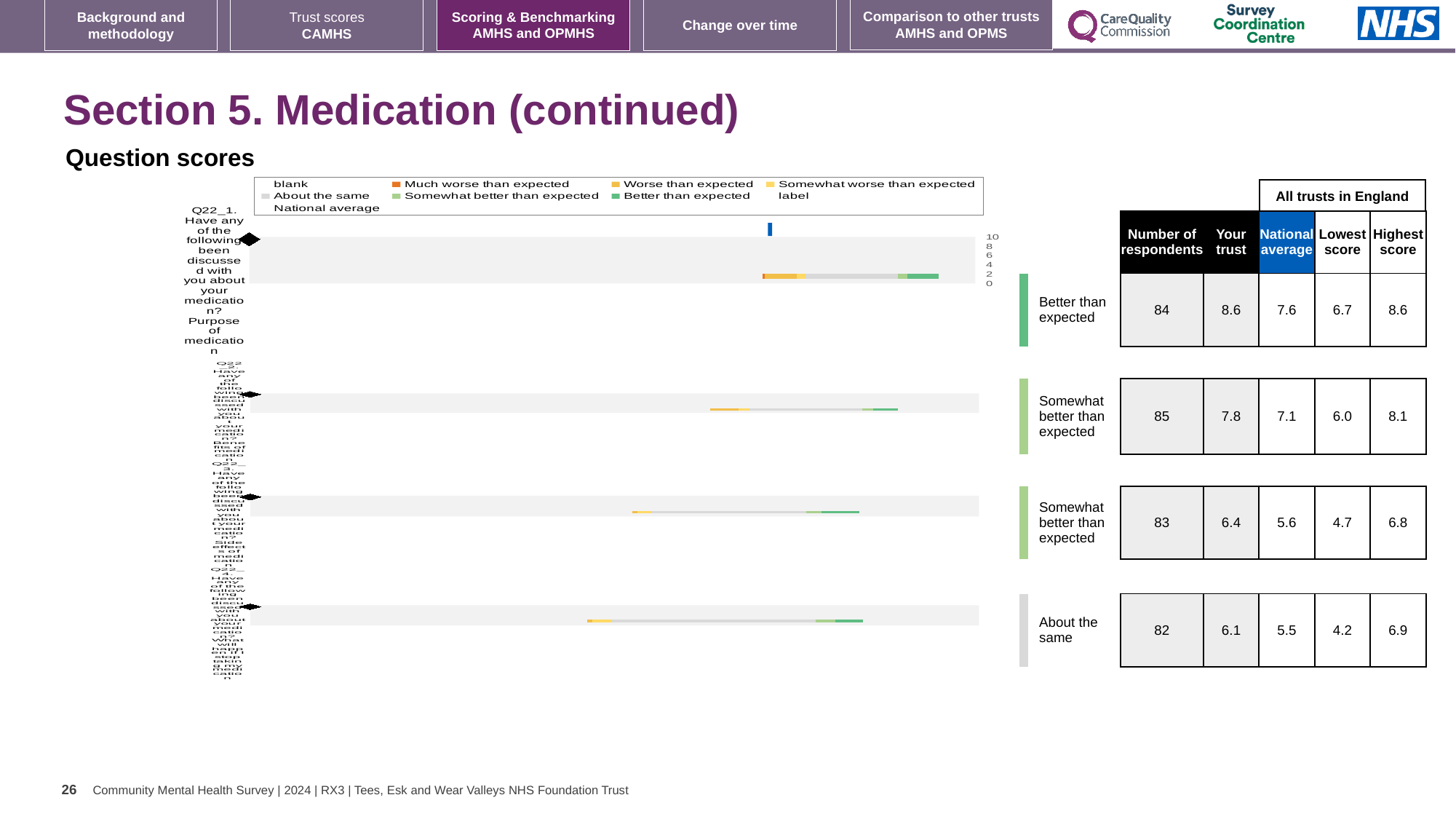
How many question rows (bars) are plotted in the question scores chart? 4 For the first row (Q22_1), how much higher is the 'Your trust' score than the national average? 1.0 What is the maximum value shown on the chart's score axis? 10 What is the highest score among all trusts in England for the third row? 6.8 What benchmark rating is shown for the first row (Q22_1)? Better than expected What is the national average for the row rated 'About the same'? 5.5 Which row has the highest 'Your trust' score? The first row (Q22_1, purpose of medication), 8.6 For the second row, which is larger: the 'Your trust' score or the national average? Your trust (7.8) How many respondents are listed for the first row (Q22_1, purpose of medication)? 84 What kind of chart is used to show the question scores on this slide? Bar chart What is the 'Your trust' score for the first row (Q22_1, purpose of medication)? 8.6 Which row has the lowest 'Lowest score' value among all trusts in England? The fourth row (About the same), 4.2